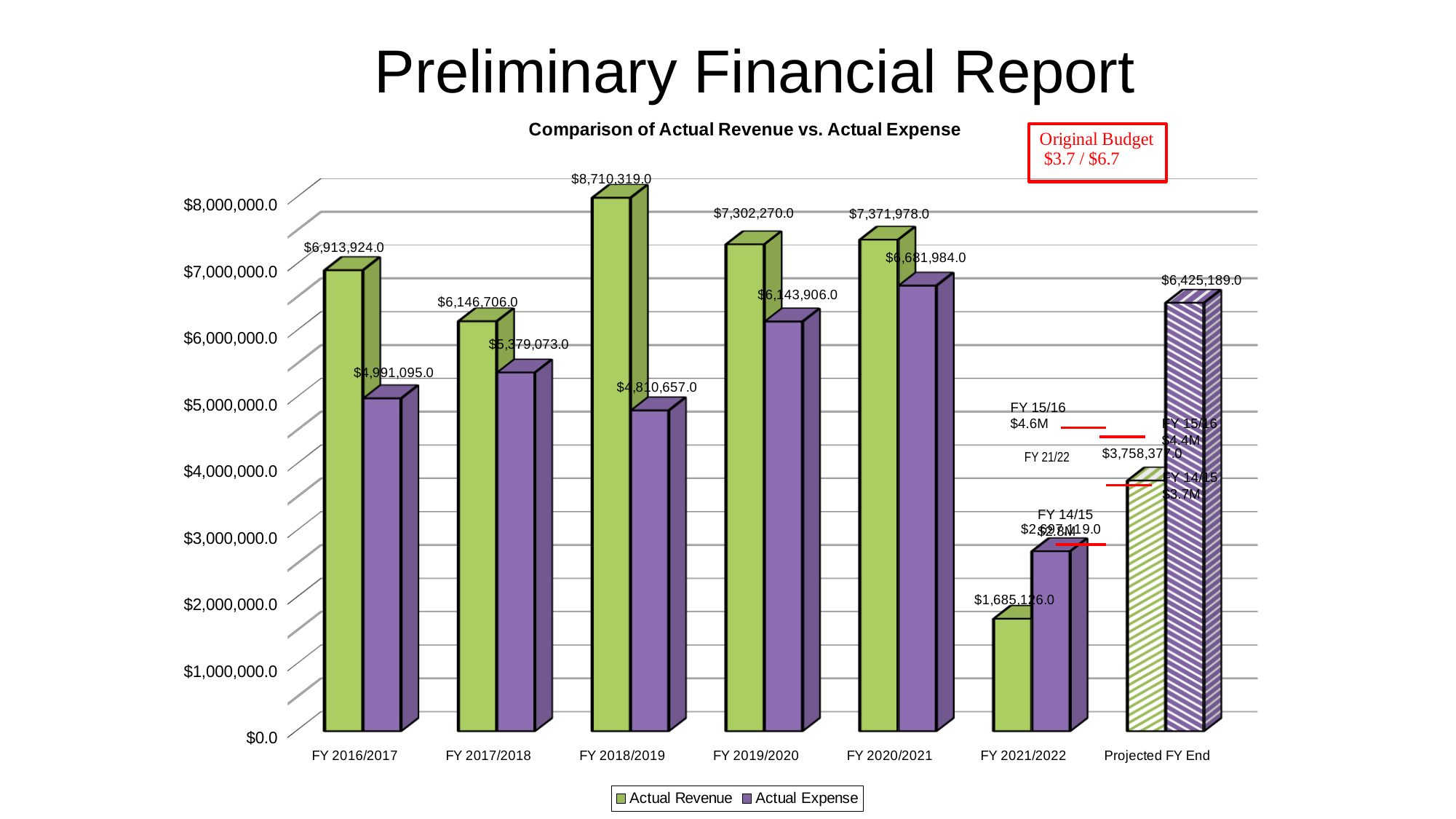
What is the difference between Actual Revenue and Actual Expense for FY 2016/2017? $1,922,829.0 What kind of chart is shown on the slide? bar chart How many categories are shown on the x axis? 7 For Projected FY End, which is larger: Actual Revenue or Actual Expense? Actual Expense How many series does the legend list? 2 What is the Actual Revenue for FY 2018/2019? $8,710,319.0 What is the Actual Expense for FY 2019/2020? $6,143,906.0 Which category has the lowest Actual Revenue? FY 2021/2022 Is the Actual Revenue for FY 2021/2022 greater or less than $2,000,000.0? less Which fiscal year has the highest Actual Revenue? FY 2018/2019 What is the title of the chart? Comparison of Actual Revenue vs. Actual Expense What is the Actual Expense for Projected FY End? $6,425,189.0